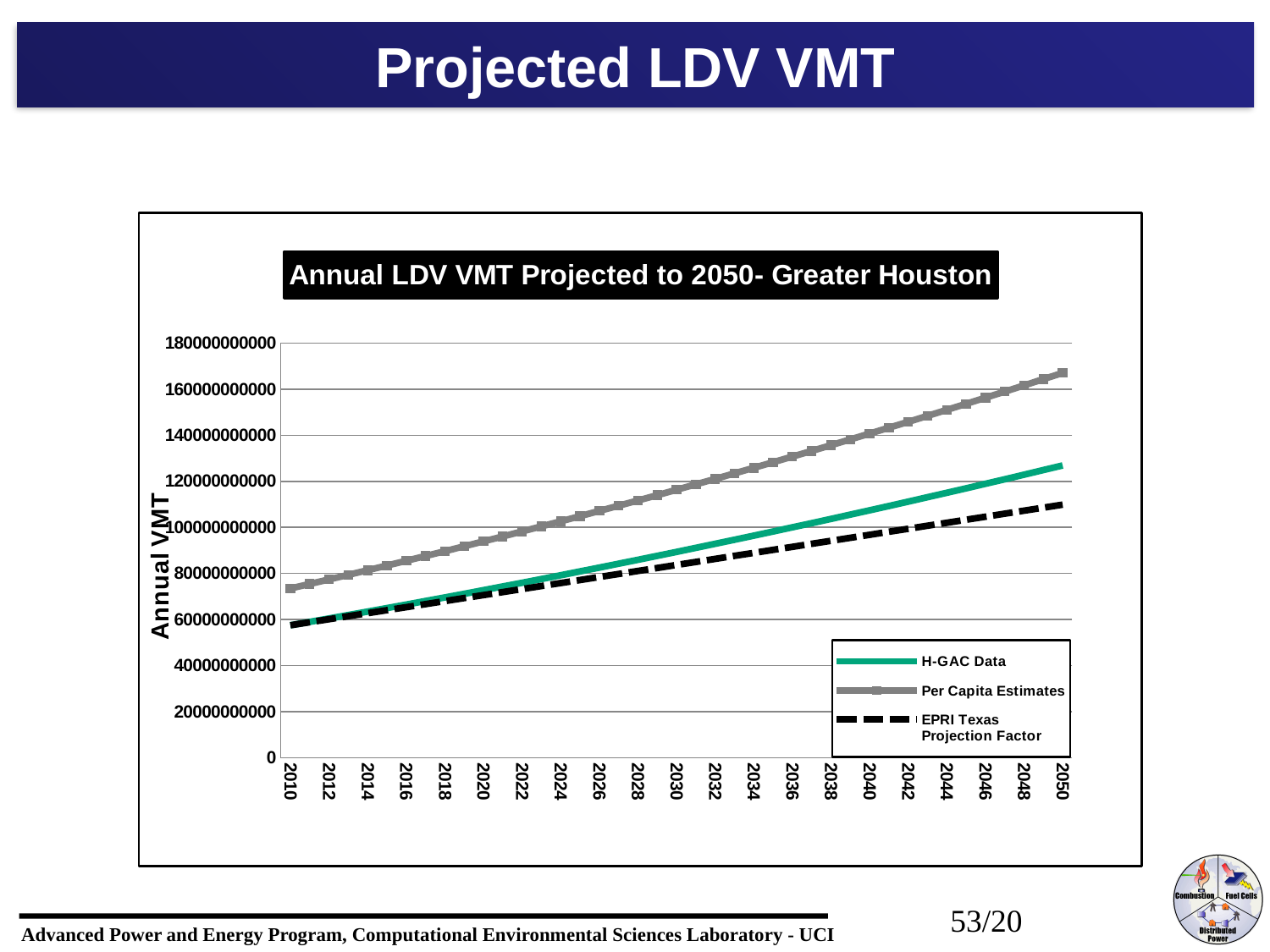
How many year labels are shown on the x axis? 21 Is the value for Per Capita Estimates in 2010 greater or less than 80000000000? less In 2050, which is larger: H-GAC Data or EPRI Texas Projection Factor? H-GAC Data Does the Per Capita Estimates series rise or fall from 2010 to 2050? Rise Which series has the highest value in 2050? Per Capita Estimates Is the value for H-GAC Data in 2010 greater or less than 60000000000? less What kind of chart is shown on the slide? Line chart Which series has the lowest value in 2050? EPRI Texas Projection Factor Is the value for Per Capita Estimates in 2050 greater or less than 160000000000? greater What is the title of the chart? Annual LDV VMT Projected to 2050- Greater Houston What is the label on the vertical axis? Annual VMT How many series does the legend list? 3